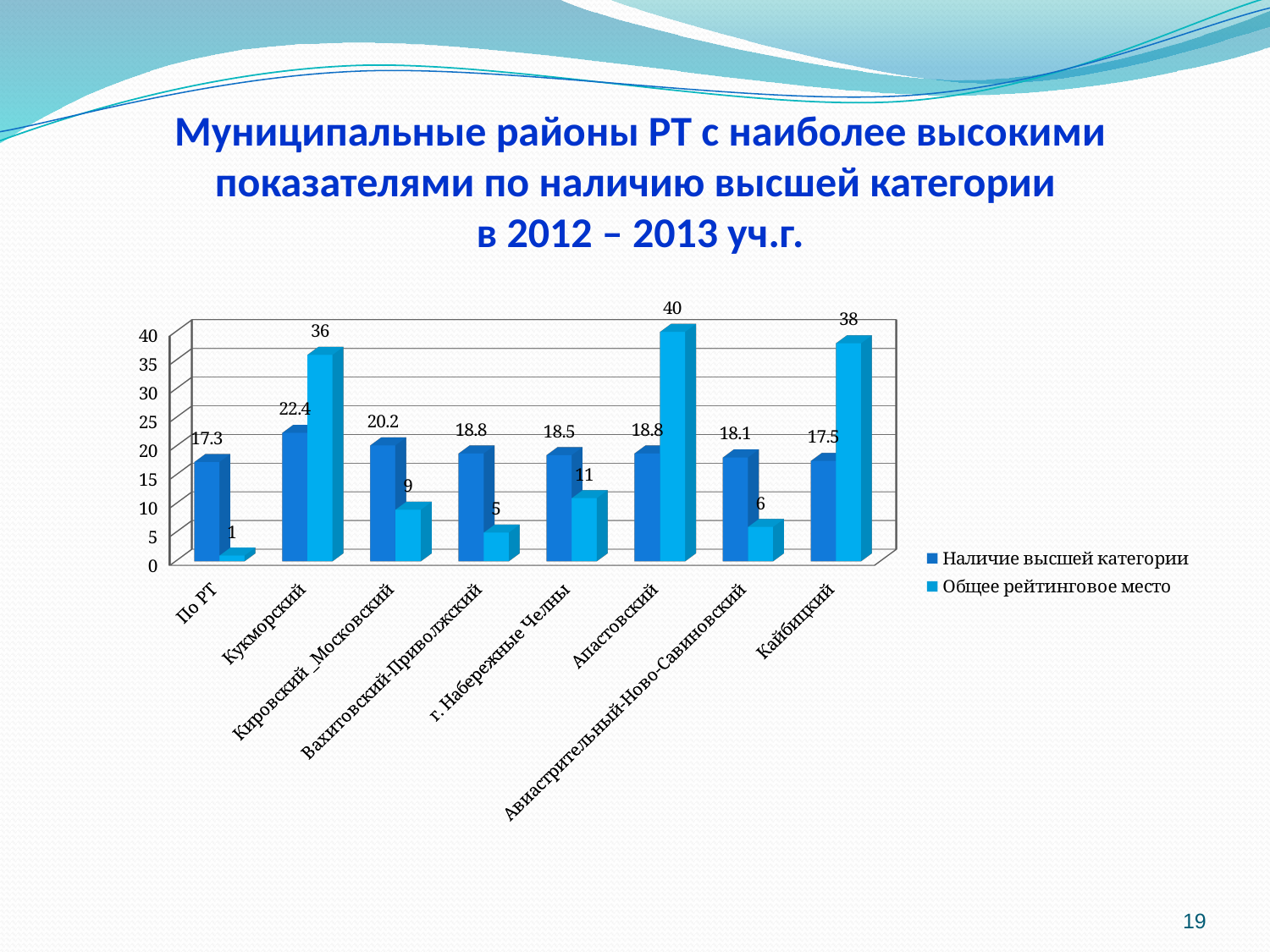
What is the name of the second series in the legend? Общее рейтинговое место What is the value of "Наличие высшей категории" for Кукморский? 22.4 Which is larger: the "Наличие высшей категории" value for Кировский_Московский or for Кайбицкий? Кировский_Московский What is the value of "Общее рейтинговое место" for Апастовский? 40 What is the value of "Наличие высшей категории" for По РТ? 17.3 What is the difference between the "Общее рейтинговое место" values for Кайбицкий and Кукморский? 2 What type of chart is shown on the slide? Bar chart Which category has the highest value of "Наличие высшей категории"? Кукморский Which category has the lowest value of "Общее рейтинговое место"? По РТ How many series does the legend list? 2 What is the value of "Общее рейтинговое место" for г. Набережные Челны? 11 How many categories are shown on the x axis? 8